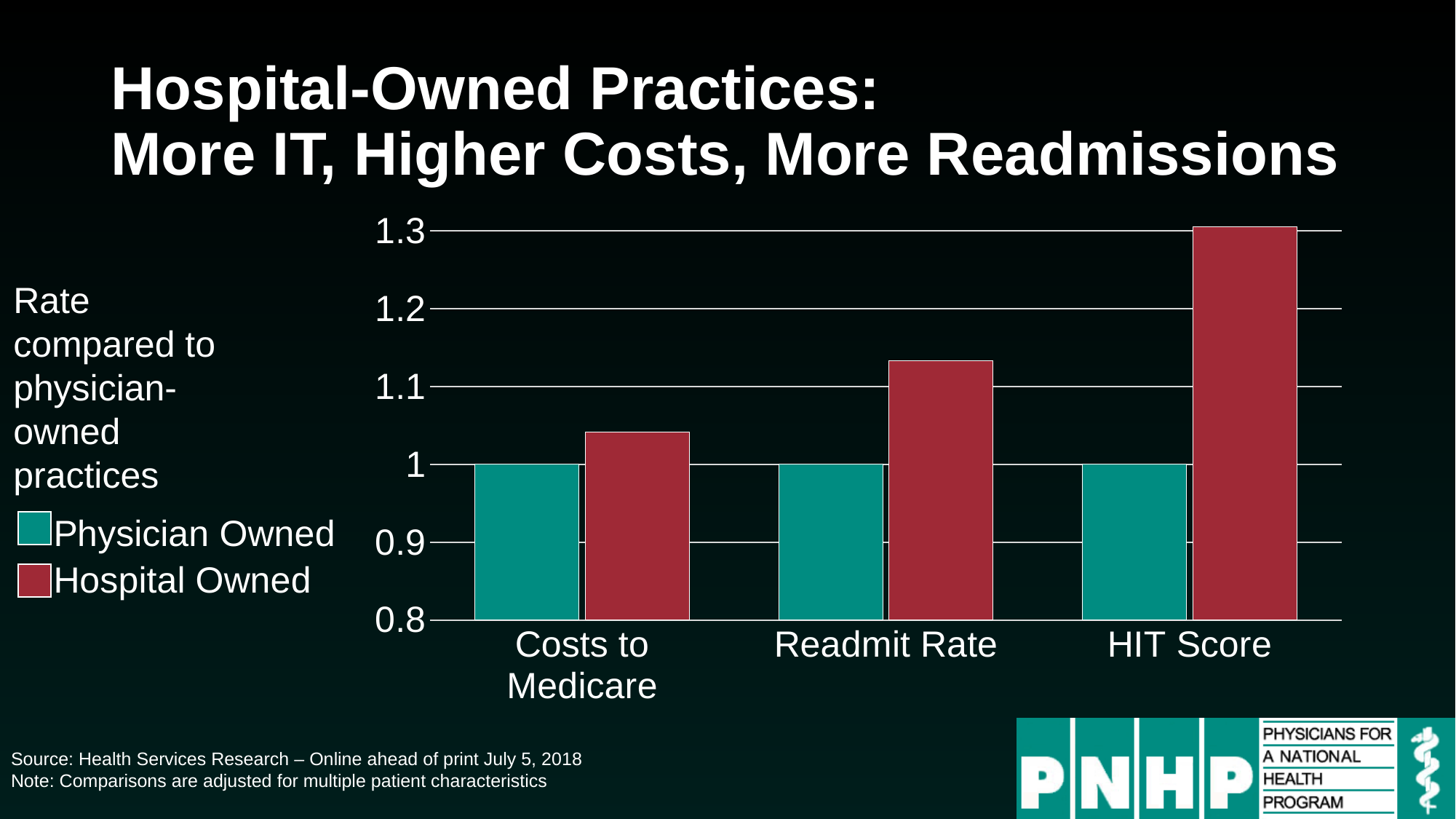
How many categories are shown on the x axis of the chart? 3 How many series does the chart's legend list? 2 Is the Hospital Owned value for Readmit Rate greater or less than 1.1? greater Which category has the highest Hospital Owned value? HIT Score In the Readmit Rate category, which series has the larger value, Physician Owned or Hospital Owned? Hospital Owned Is the Hospital Owned value for HIT Score greater or less than 1.2? greater Do the Hospital Owned values rise or fall moving from Costs to Medicare to HIT Score along the x axis? rise Which category has the lowest Hospital Owned value? Costs to Medicare Is the Hospital Owned value for Costs to Medicare greater or less than 1.1? less What is the value for Physician Owned in the Readmit Rate category? 1 What is the value for Physician Owned in the HIT Score category? 1 What kind of chart is shown on the slide? bar chart